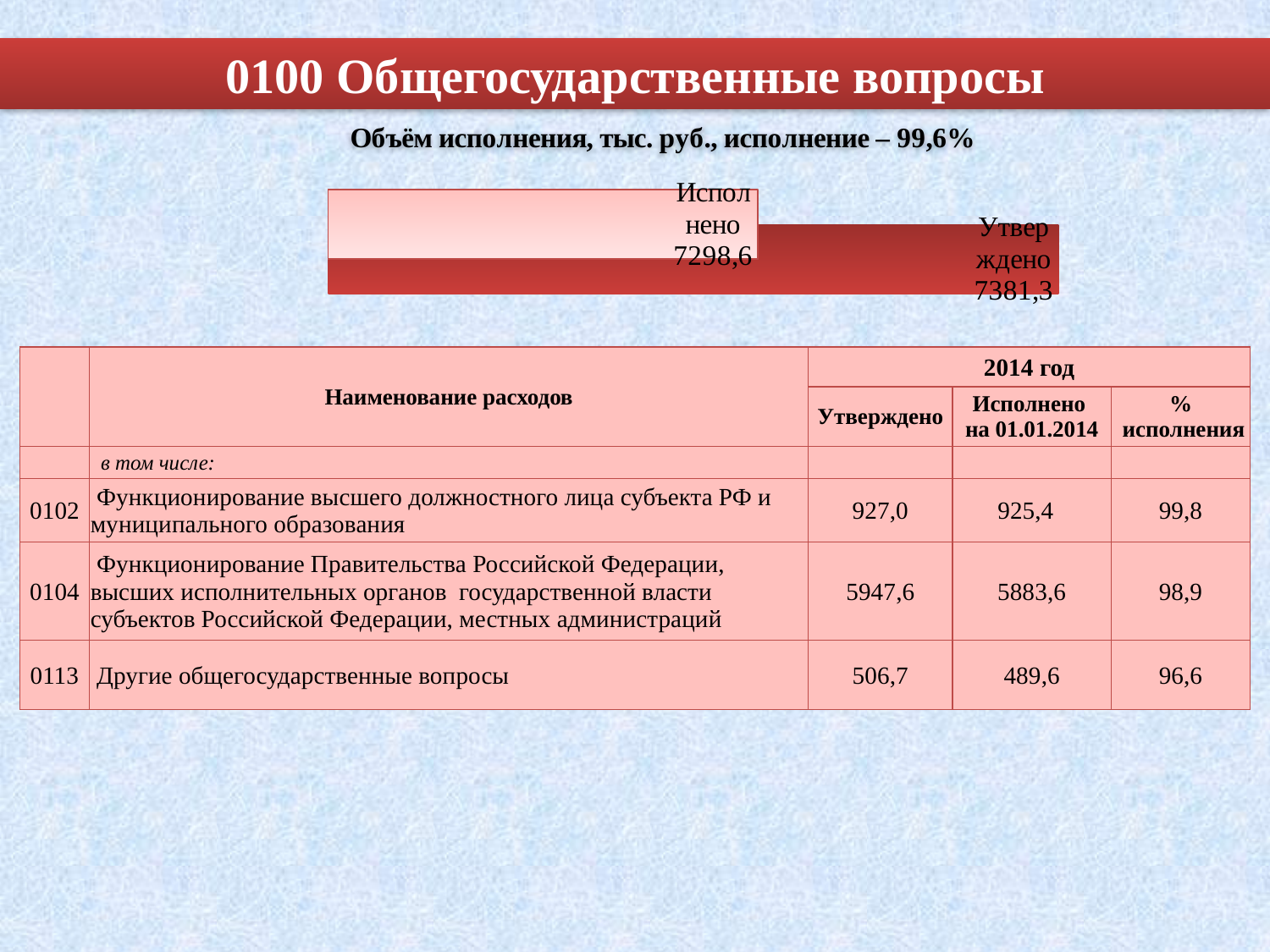
What is the value shown for Исполнено in the chart? 7298,6 Which category in the chart has the higher value, Исполнено or Утверждено? Утверждено What execution percentage is stated in the chart title? 99,6% How many categories are shown in the chart? 2 What is the difference between the Утверждено value and the Исполнено value in the chart? 82,7 What is the title of the chart on the slide? Объём исполнения, тыс. руб., исполнение – 99,6% Which category in the chart has the smallest value? Исполнено Which category in the chart has the largest value? Утверждено What kind of chart is shown on the slide? bar chart What is the value shown for Утверждено in the chart? 7381,3